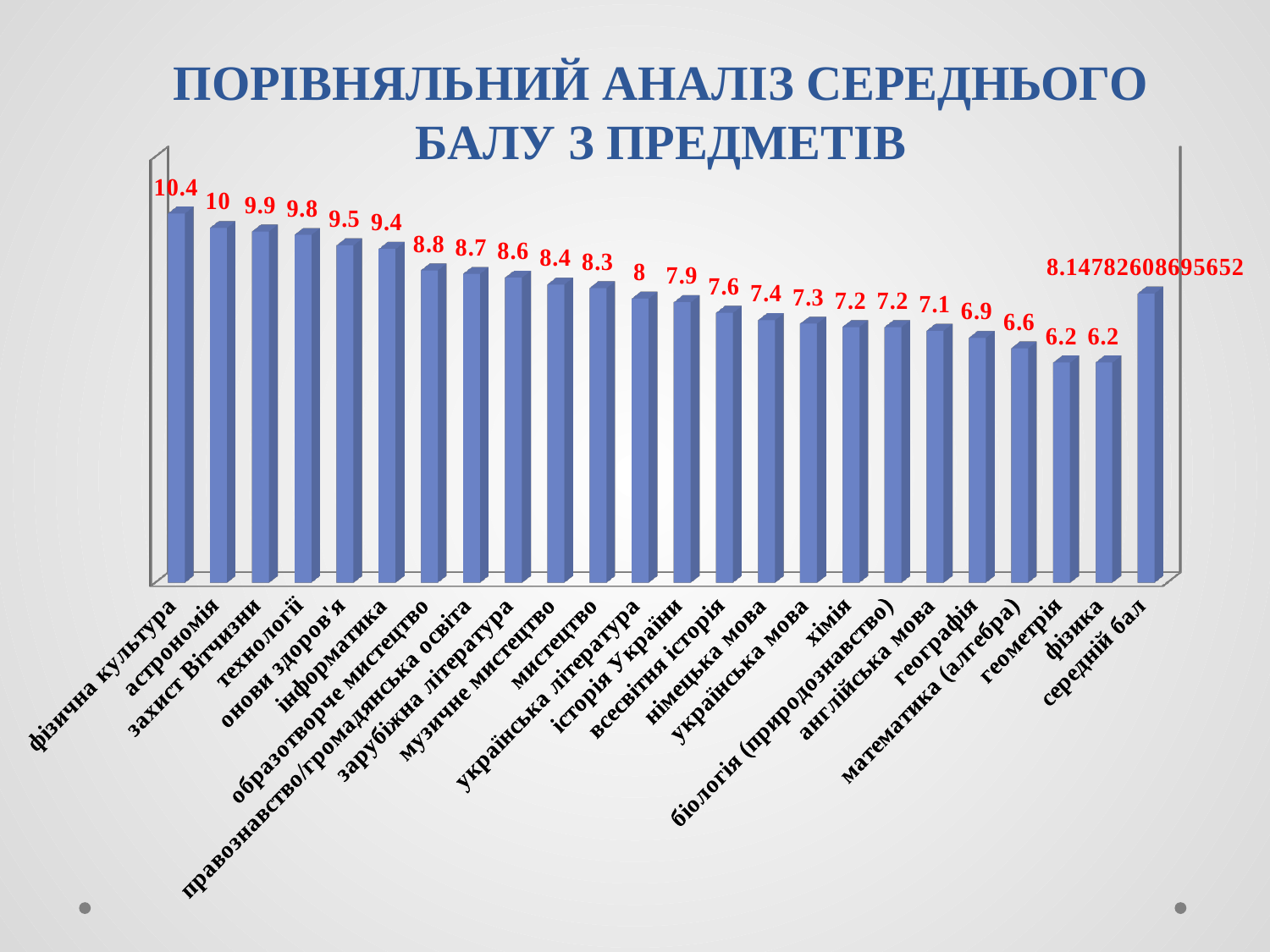
What is the average score for географія? 6.9 Which subject has the highest average score? фізична культура Which has a higher average score, хімія or технології? технології What is the average score for фізична культура? 10.4 What is the average score for інформатика? 9.4 What type of chart is shown on the slide? bar chart How many bars are plotted in the chart? 24 What is the difference between the average scores for астрономія and фізика? 3.8 Which has a higher average score, німецька мова or англійська мова? німецька мова What is the value shown for середній бал? 8.14782608695652 What is the difference between the average scores for зарубіжна література and математика (алгебра)? 2 What is the title of the chart? ПОРІВНЯЛЬНИЙ АНАЛІЗ СЕРЕДНЬОГО БАЛУ З ПРЕДМЕТІВ